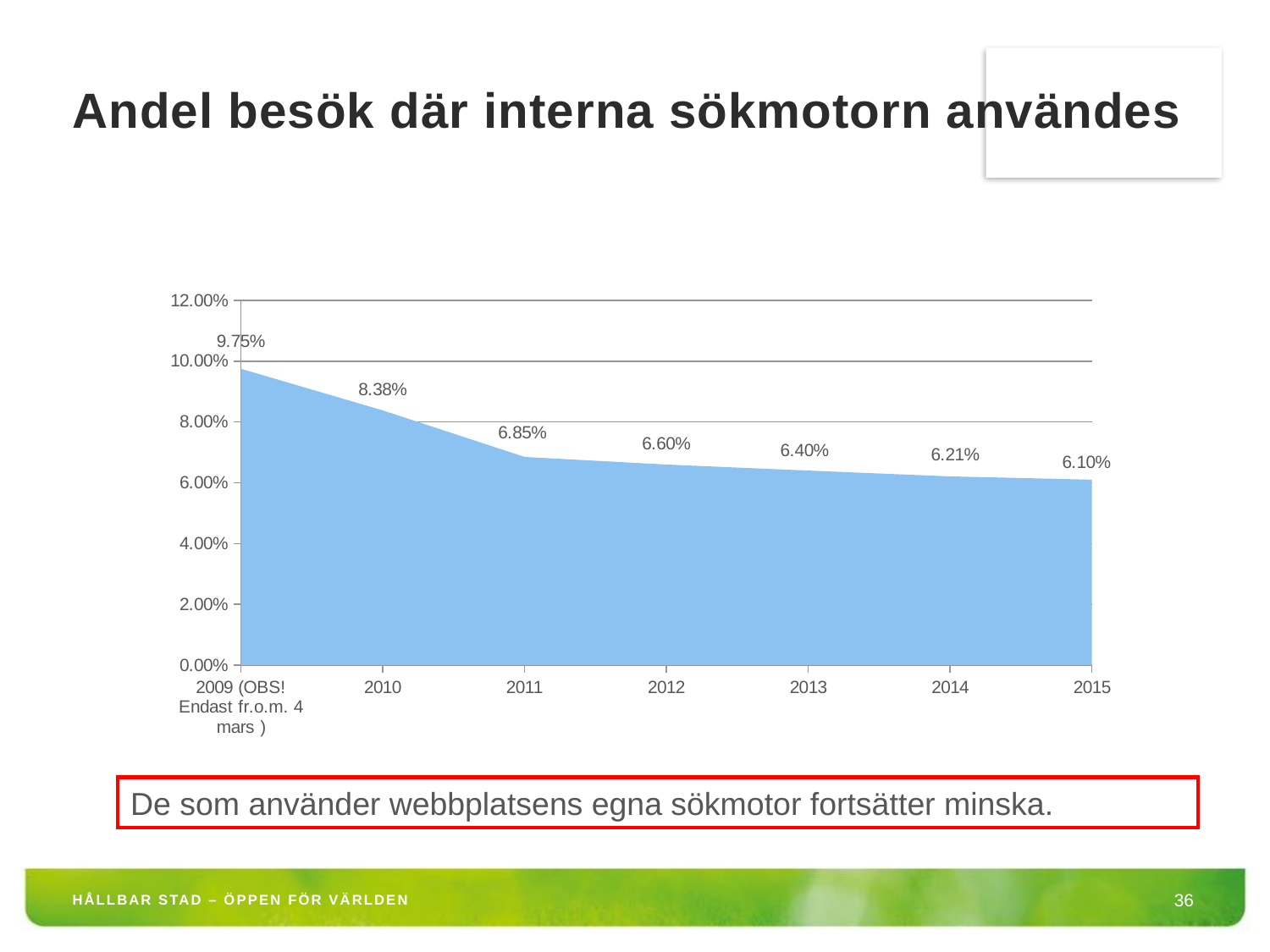
How many years are plotted on the chart? 7 What is the difference between the values for 2010 and 2011? 1.53% Which year has the highest value? 2009 What is the value for 2013? 6.40% What is the difference between the values for 2009 and 2015? 3.65% What is the value for 2010? 8.38% Do the values rise or fall from 2009 to 2015? fall Is the value for 2012 greater or less than 8.00%? less What is the value for 2015? 6.10% What kind of chart is shown on the slide? area chart Which is larger, the value for 2011 or the value for 2014? 2011 Which year has the lowest value? 2015